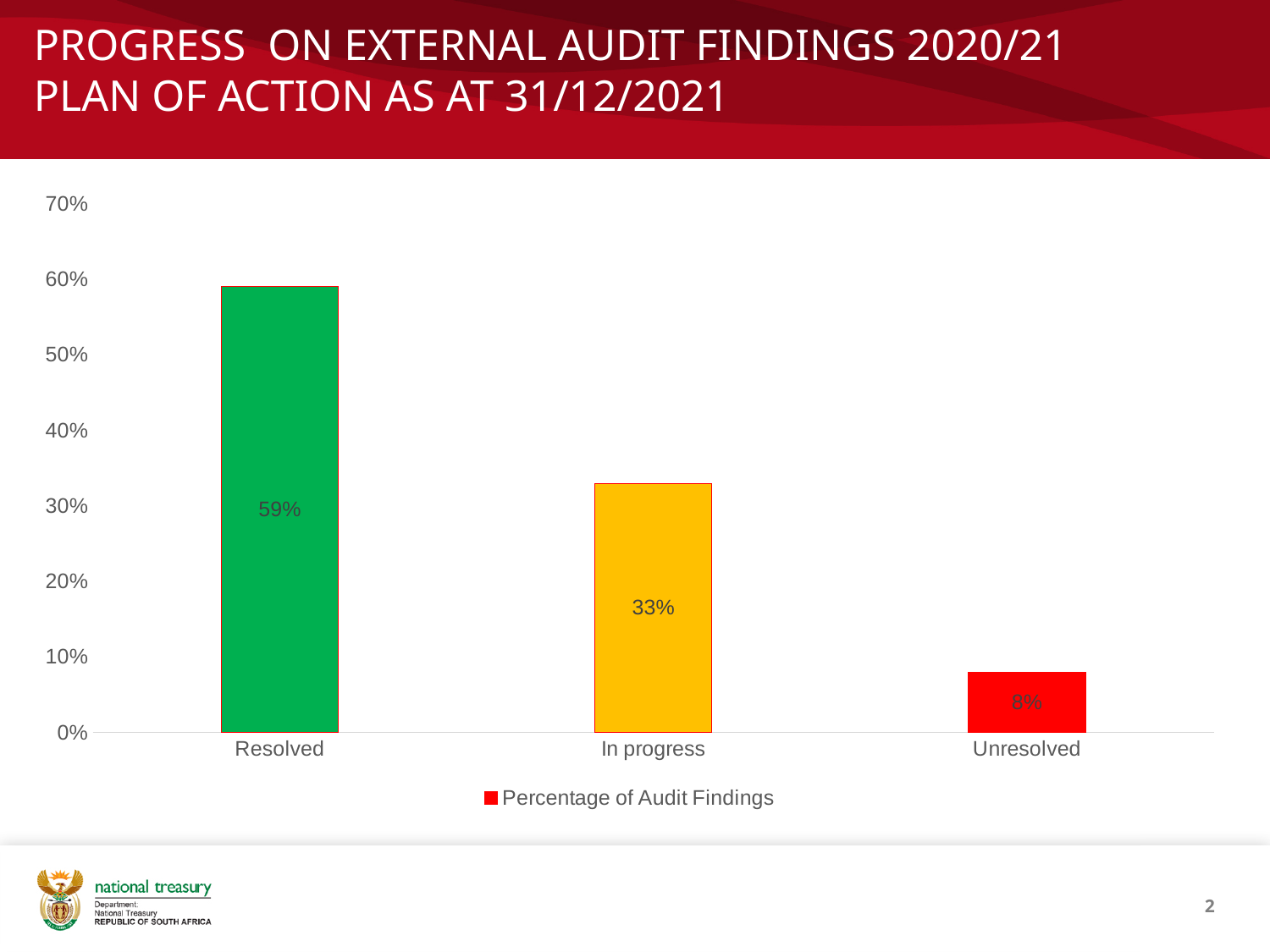
How many categories are shown on the x axis? 3 Is the value for Resolved greater or less than 50%? greater What percentage of audit findings are Unresolved? 8% Which is larger, the percentage for In progress or for Unresolved? In progress What kind of chart is shown on the slide? Bar chart What is the difference in percentage points between Resolved and In progress? 26% Which category has the highest percentage of audit findings? Resolved What is the difference in percentage points between In progress and Unresolved? 25% Which category has the lowest percentage of audit findings? Unresolved What percentage of audit findings are In progress? 33% What percentage of audit findings are Resolved? 59% What series name does the legend show? Percentage of Audit Findings